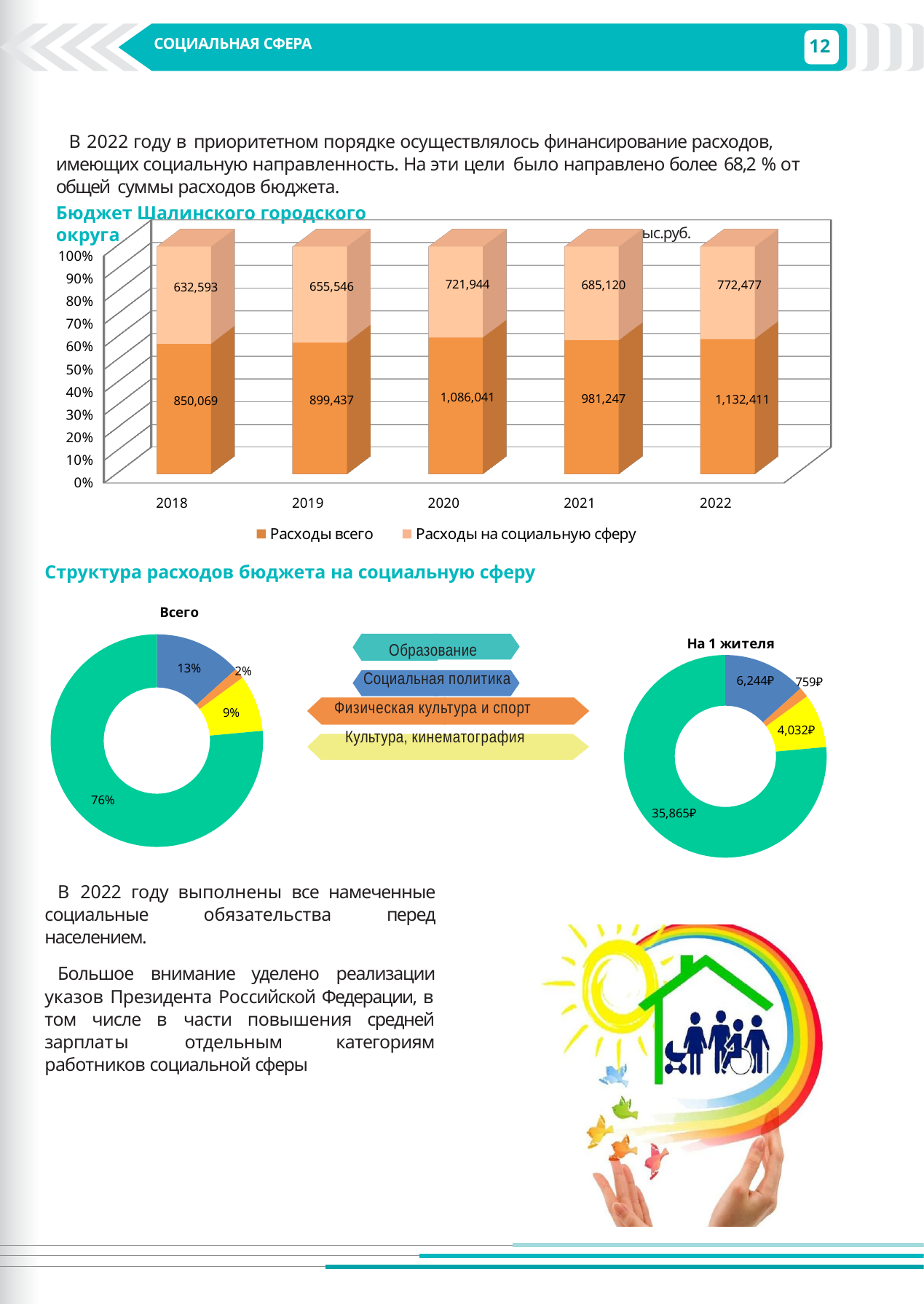
In the chart 'Бюджет Шалинского городского округа', which year has the larger value for 'Расходы на социальную сферу': 2020 or 2021? 2020 In the doughnut chart 'Всего', what is the largest share shown? 76% In the chart 'Бюджет Шалинского городского округа', which year has the highest value for 'Расходы всего'? 2022 In the chart 'Бюджет Шалинского городского округа', what is the value of 'Расходы всего' for 2020? 1,086,041 In the chart 'Бюджет Шалинского городского округа', how many series does the legend list? 2 What type of chart is 'Бюджет Шалинского городского округа'? Bar chart In the chart 'Бюджет Шалинского городского округа', which year has the lowest value for 'Расходы на социальную сферу'? 2018 In the chart 'Бюджет Шалинского городского округа', what is the value of 'Расходы на социальную сферу' for 2018? 632,593 In the chart 'Бюджет Шалинского городского округа', how many years are shown on the x axis? 5 In the doughnut chart 'Всего', what share is shown for 'Культура, кинематография'? 9% In the chart 'Бюджет Шалинского городского округа', what is the difference between 'Расходы всего' in 2022 and in 2021? 151,164 In the doughnut chart 'На 1 жителя', what is the value for 'Социальная политика'? 6,244₽